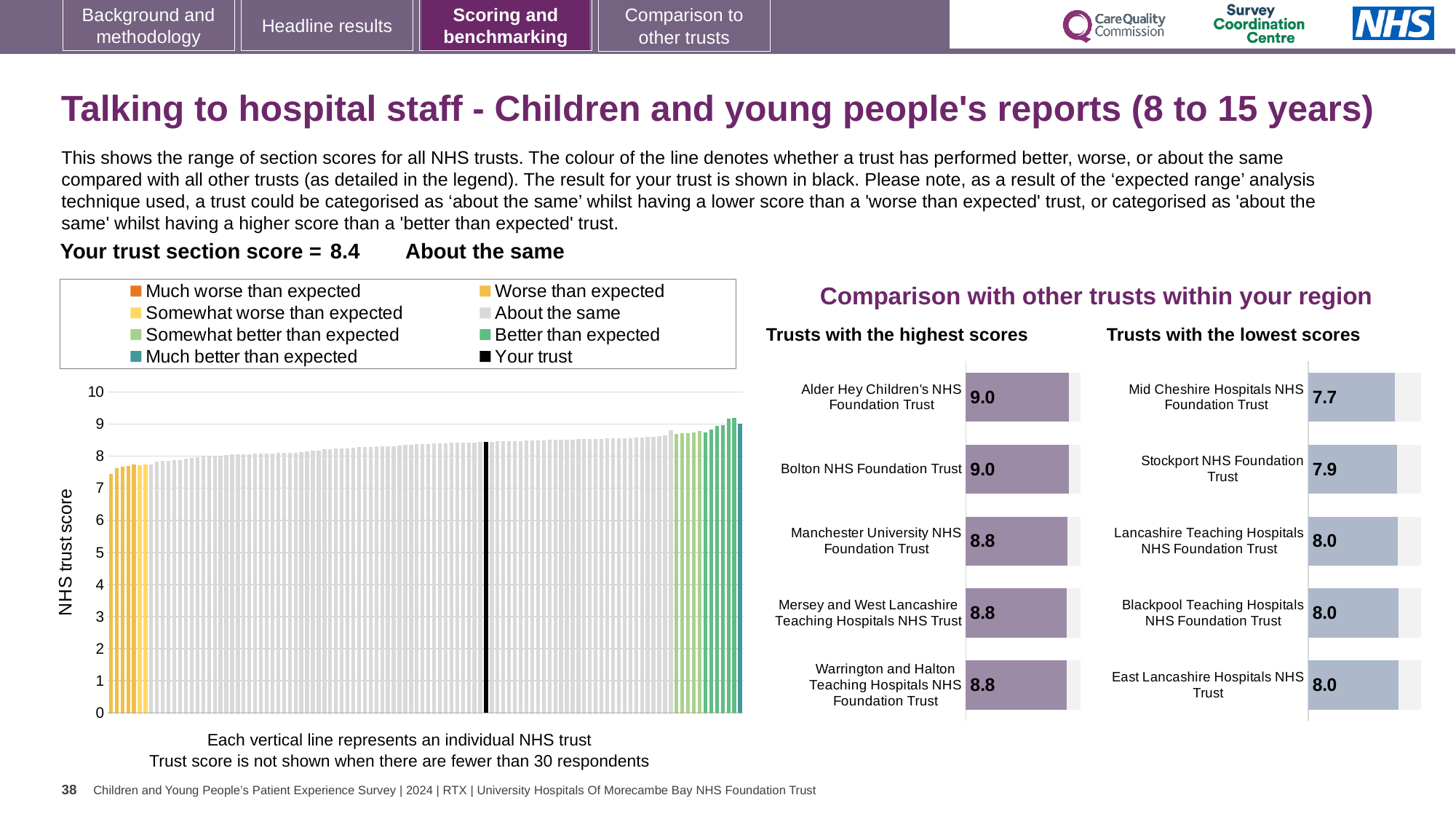
In the 'Trusts with the lowest scores' chart, which has the larger score: Stockport NHS Foundation Trust or Mid Cheshire Hospitals NHS Foundation Trust? Stockport NHS Foundation Trust How many trusts are shown in the 'Trusts with the highest scores' chart? 5 In the 'Trusts with the highest scores' chart, what is the score for Manchester University NHS Foundation Trust? 8.8 In the 'Trusts with the lowest scores' chart, what is the score for Mid Cheshire Hospitals NHS Foundation Trust? 7.7 How many entries does the legend of the large chart on the left list? 8 In the 'Trusts with the lowest scores' chart, what is the score for Stockport NHS Foundation Trust? 7.9 In the 'Trusts with the highest scores' chart, what is the difference between the scores of Alder Hey Children's NHS Foundation Trust and Warrington and Halton Teaching Hospitals NHS Foundation Trust? 0.2 In the 'Trusts with the highest scores' chart, what is the score for Alder Hey Children's NHS Foundation Trust? 9.0 In the 'Trusts with the lowest scores' chart, what is the difference between the scores of Stockport NHS Foundation Trust and Mid Cheshire Hospitals NHS Foundation Trust? 0.2 In the large chart on the left, do the trust scores rise or fall from left to right along the x axis? Rise In the 'Trusts with the lowest scores' chart, which trust has the lowest score? Mid Cheshire Hospitals NHS Foundation Trust What kind of chart is the large chart on the left showing NHS trust scores? Bar chart